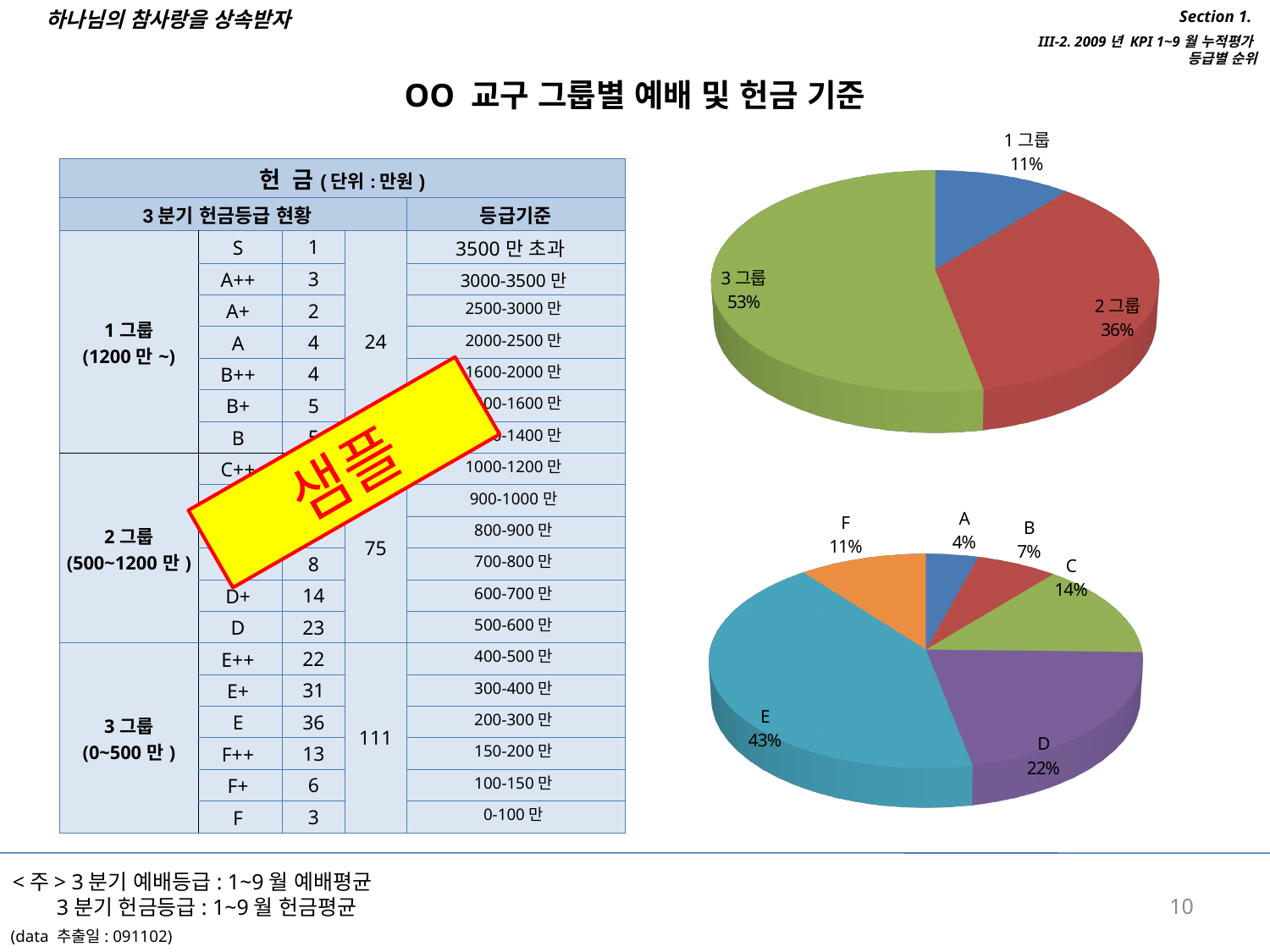
In the top pie chart on the right, what share does 1 그룹 have? 11% In the top pie chart on the right, what share does 3 그룹 have? 53% In the bottom pie chart on the right, which is larger, D or F? D In the top pie chart on the right, how many slices are there? 3 In the top pie chart on the right, what is the difference in percentage points between 2 그룹 and 1 그룹? 25 What type of chart is the bottom chart on the right? Pie chart In the bottom pie chart on the right, which category has the smallest slice? A In the bottom pie chart on the right, how many categories are shown? 6 In the top pie chart on the right, which group has the smallest slice? 1 그룹 In the top pie chart on the right, which group has the largest slice? 3 그룹 In the bottom pie chart on the right, what share does C have? 14% In the bottom pie chart on the right, what share does E have? 43%